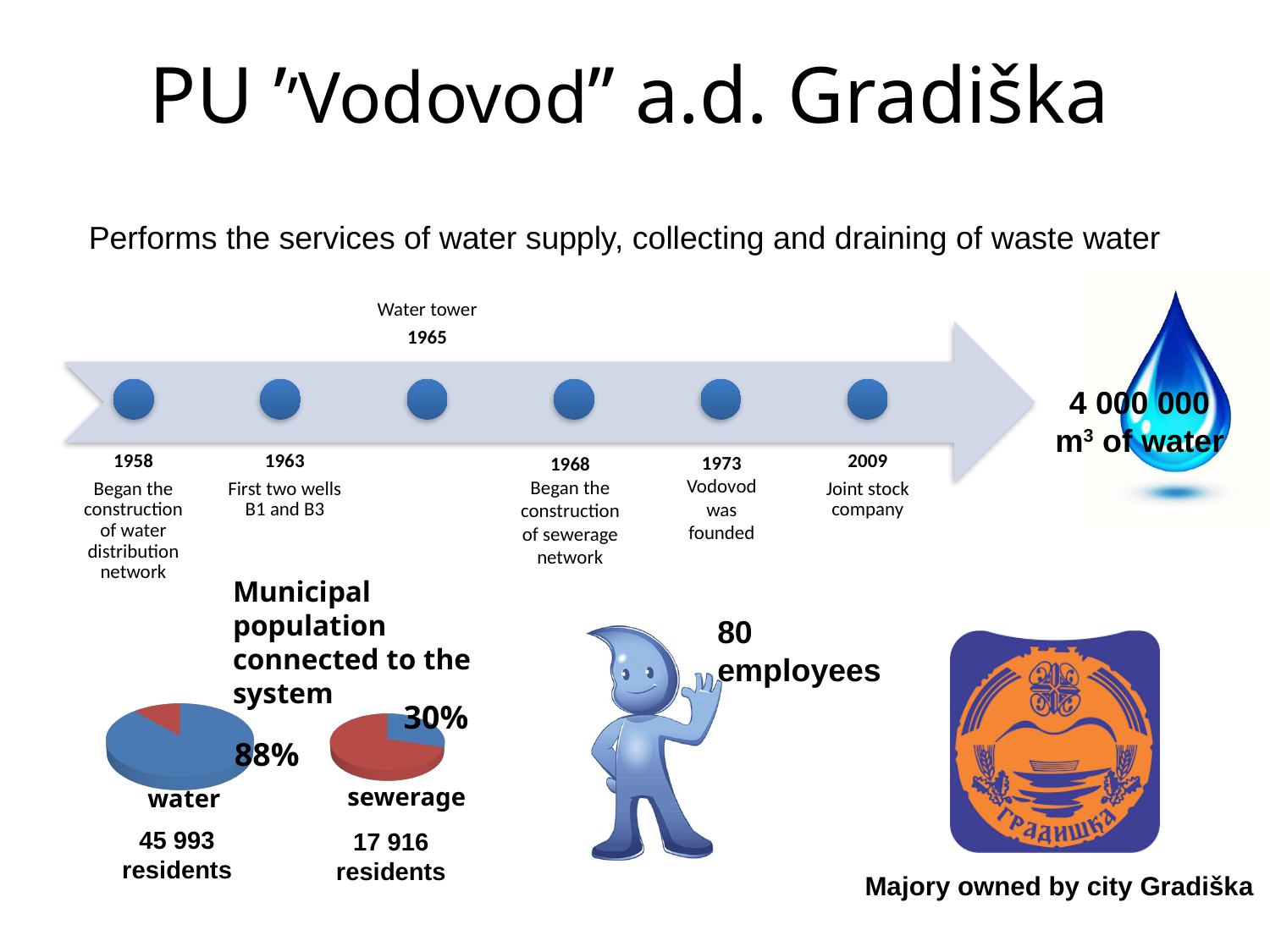
What heading is written above the two pie charts? Municipal population connected to the system How many slices does the 'water' pie chart have? 2 In the 'water' pie chart, is the labelled connected share greater or less than 50%? greater Which pie chart shows the larger connected share, 'water' or 'sewerage'? water How many slices does the 'sewerage' pie chart have? 2 What is the difference between the connected share shown in the 'water' pie chart and the one in the 'sewerage' pie chart? 58 percentage points In the 'sewerage' pie chart, is the labelled connected share greater or less than 50%? less In the 'water' pie chart, what share of the municipal population is connected to the system? 88% What kind of chart is used to show the municipal population connected to the water system? pie chart In the 'sewerage' pie chart, what colour is the larger slice? red How many pie charts are shown on the slide? 2 In the 'sewerage' pie chart, what share of the municipal population is connected to the system? 30%